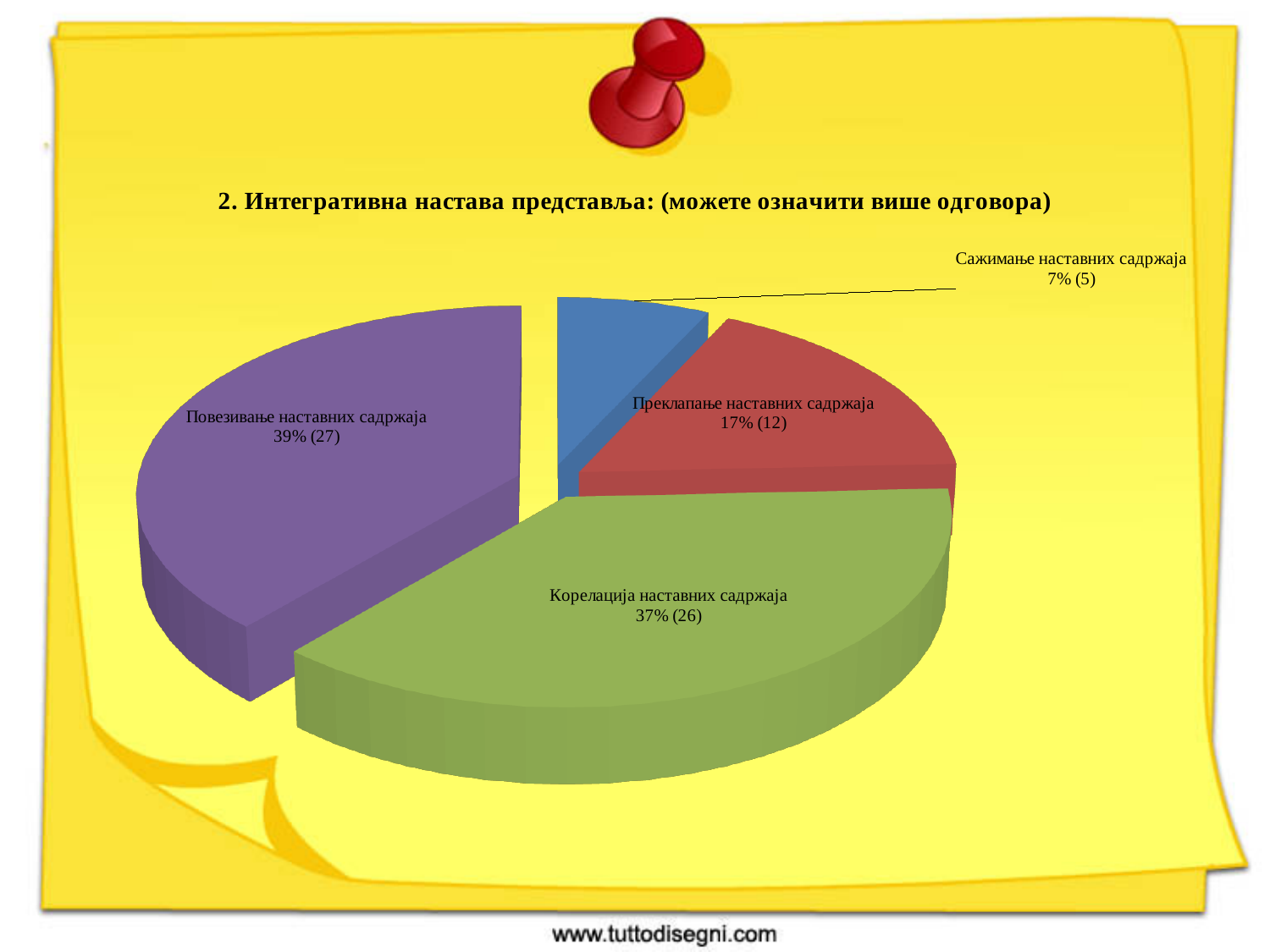
What colour is the slice for "Корелација наставних садржаја"? green Which category has the smallest slice of the pie? Сажимање наставних садржаја What kind of chart is shown on the slide? pie chart How many responses are shown for "Сажимање наставних садржаја"? 5 What percentage share does "Повезивање наставних садржаја" have in the pie chart? 39% How many responses are shown for "Корелација наставних садржаја"? 26 Which has more responses, "Корелација наставних садржаја" or "Преклапање наставних садржаја"? Корелација наставних садржаја How many categories are shown in the pie chart? 4 What is the total number of responses across all four categories? 70 Which category has the largest slice of the pie? Повезивање наставних садржаја What percentage share does "Преклапање наставних садржаја" have? 17% What is the difference in responses between "Повезивање наставних садржаја" and "Преклапање наставних садржаја"? 15